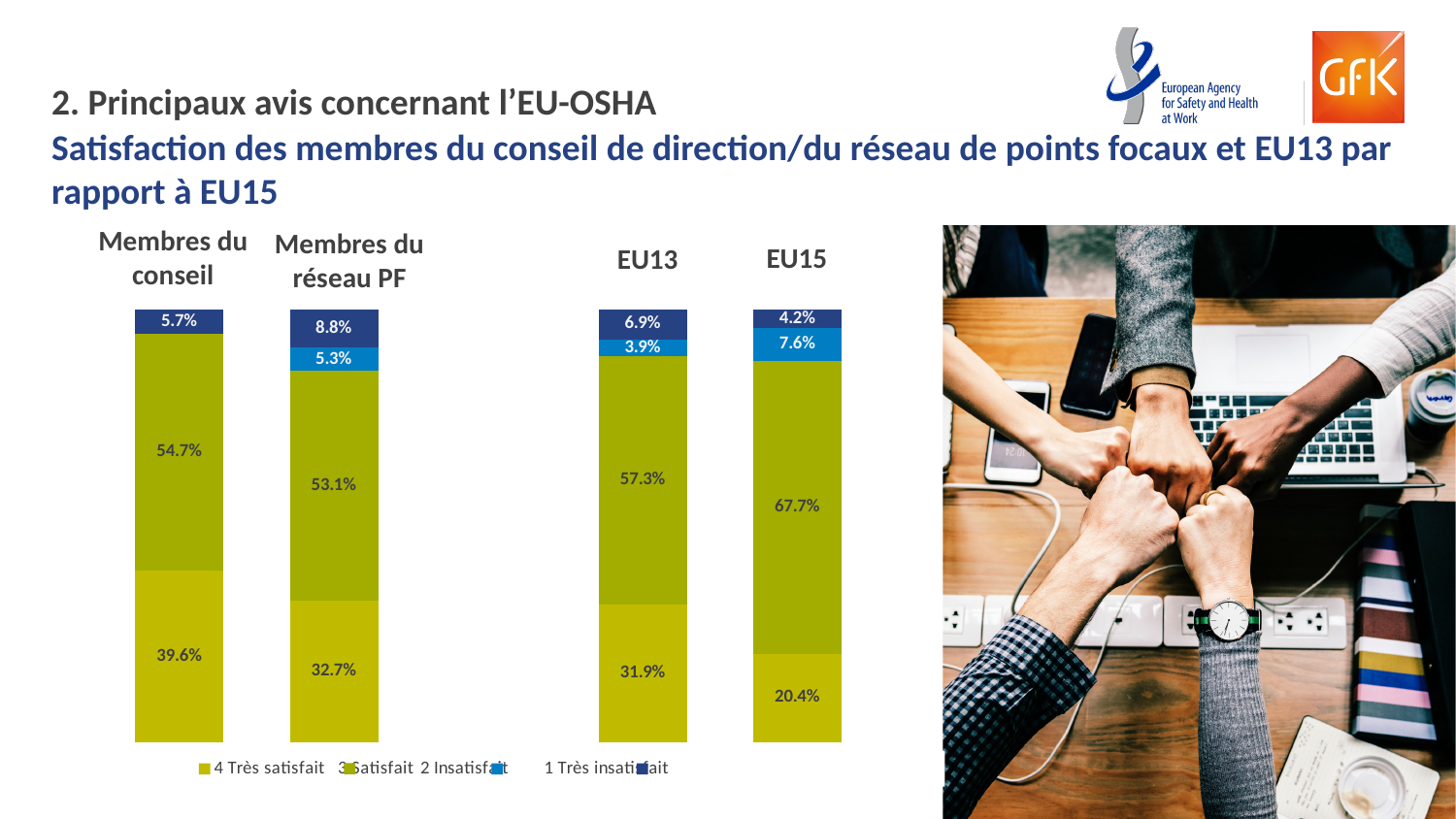
How many groups (bars) are shown in the chart? 4 What is the 'Très satisfait' share (bottom segment) for EU15? 20.4% What is the difference between the 'Satisfait' share for EU15 (67.7%) and for EU13 (57.3%)? 10.4 percentage points Which has a larger 'Très satisfait' share: Membres du conseil or Membres du réseau PF? Membres du conseil What is the combined share of 'Très satisfait' and 'Satisfait' for EU13? 89.2% How many series does the legend list? 4 What is the 'Satisfait' share (middle segment) for EU13? 57.3% What is the value of the top segment of the 'Membres du réseau PF' bar? 8.8% Which group has the lowest 'Très satisfait' share (bottom segment)? EU15 Which group has the highest 'Très satisfait' share (bottom segment)? Membres du conseil What kind of chart is shown on the slide? Stacked bar chart What are the four legend entries of the chart? 4 Très satisfait, 3 Satisfait, 2 Insatisfait, 1 Très insatisfait